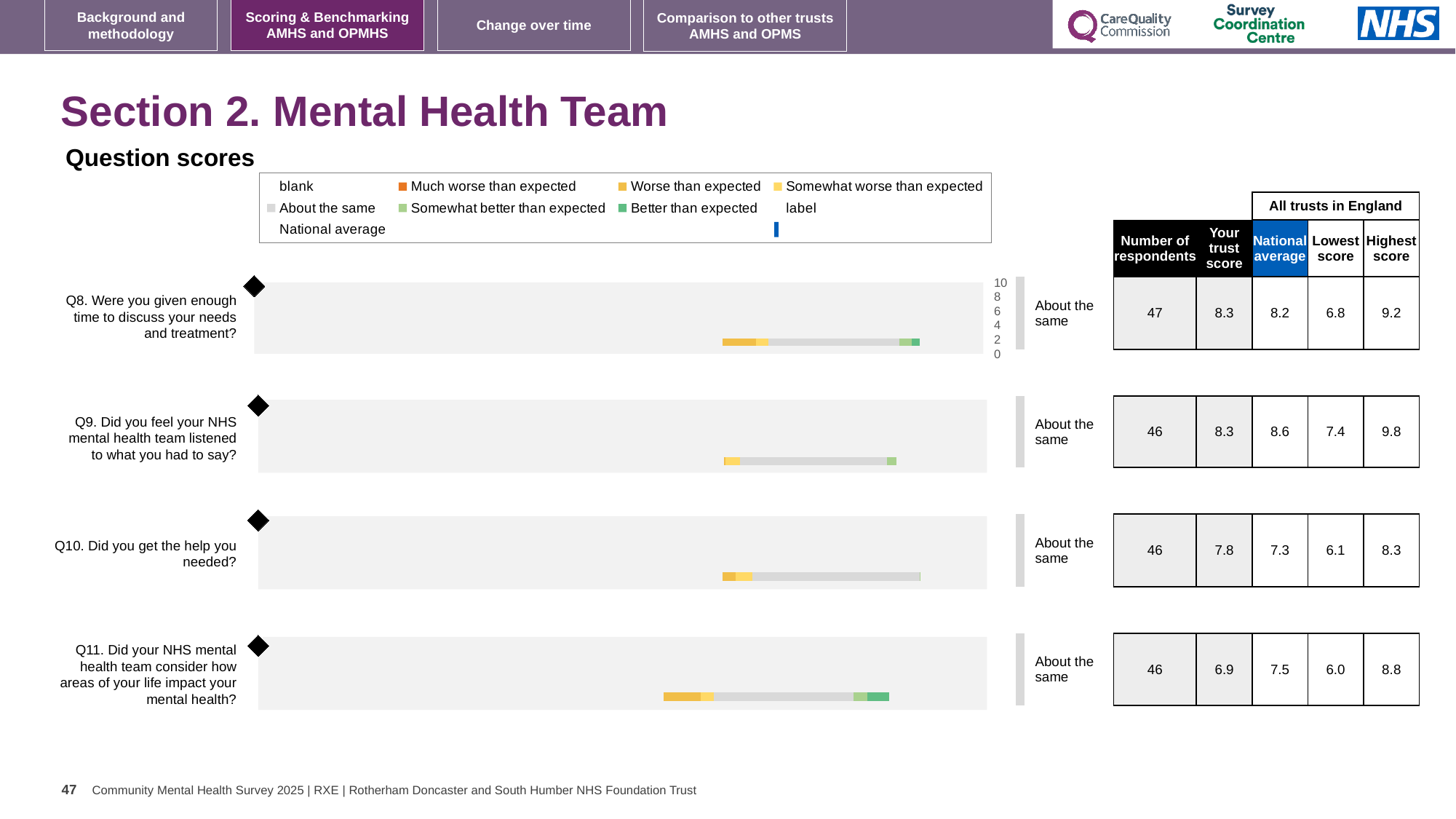
Which question has the lowest 'Your trust score' among Q8 to Q11? Q11 How many respondents are recorded for Q10 (Did you get the help you needed)? 46 What is the 'Your trust score' value for Q8 (Were you given enough time to discuss your needs and treatment)? 8.3 What kind of chart is used to show the question scores for Q8 to Q11? Bar chart What benchmark label is shown next to the Q8 bar? About the same What is the lowest score across all trusts in England for Q9? 7.4 What colour does the legend use for 'Better than expected'? Green For Q10, which is larger: the trust score or the national average? Trust score How many questions (Q8 to Q11) have a score bar plotted on the slide? 4 For Q11, what is the difference between the highest score and the lowest score across all trusts in England? 2.8 What is the highest score across all trusts in England for Q9 (Did you feel your NHS mental health team listened to what you had to say)? 9.8 What is the national average score for Q11 (Did your NHS mental health team consider how areas of your life impact your mental health)? 7.5